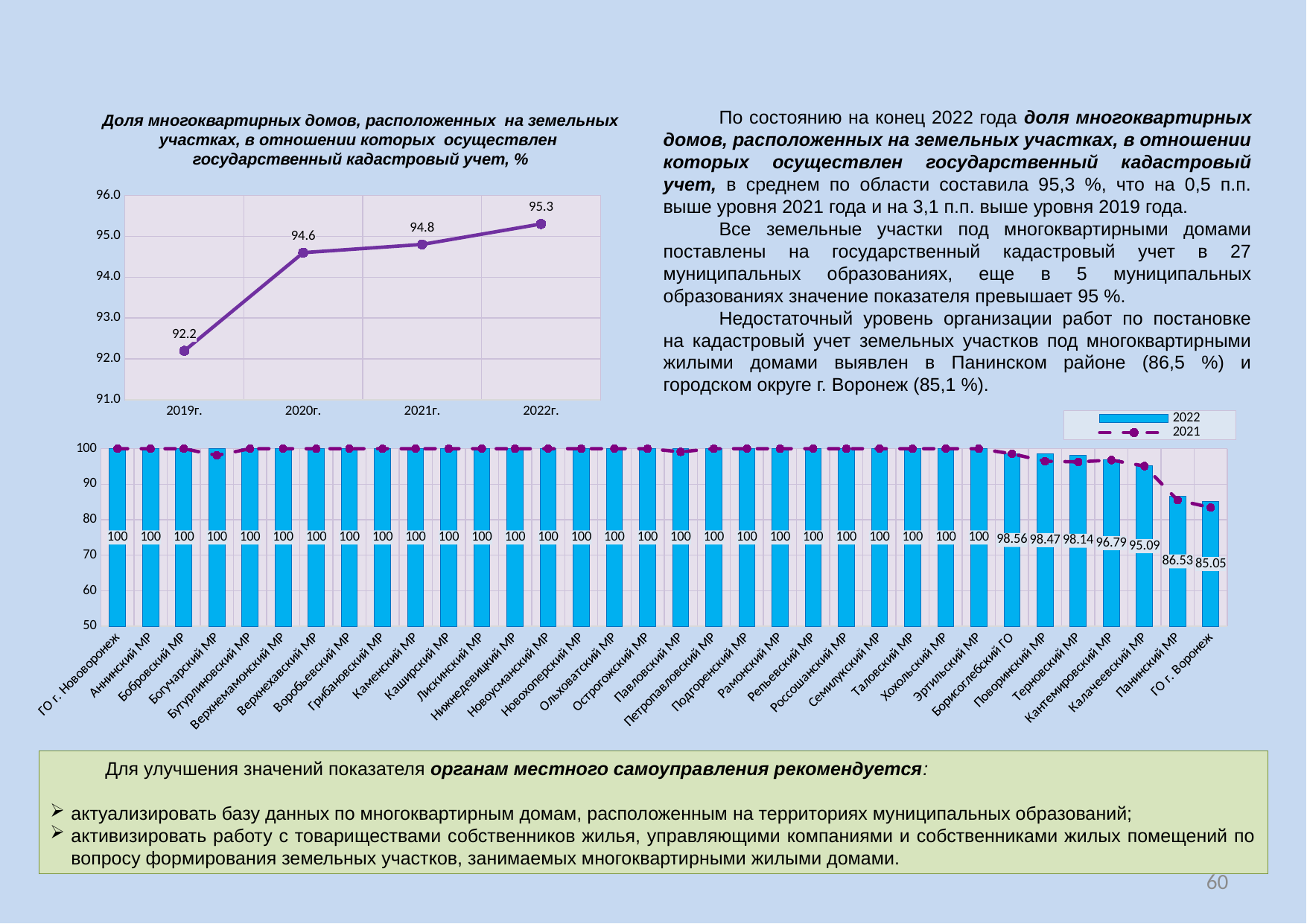
What kind of chart is the top-left chart? line chart In the bottom bar chart, which municipality has the lowest 2022 value? ГО г. Воронеж How many series does the legend of the bottom bar chart list? 2 In the top-left line chart, what is the value for 2019г.? 92.2 In the top-left line chart, what is the difference between the 2022г. and 2019г. values? 3.1 In the bottom bar chart, what is the difference between the 2022 values for Борисоглебский ГО and Поворинский МР? 0.09 In the top-left line chart, what is the value for 2022г.? 95.3 In the bottom bar chart, what is the 2022 value for ГО г. Воронеж? 85.05 In the top-left line chart, how many years are plotted? 4 In the top-left line chart, do the values rise or fall from 2019г. to 2022г.? rise In the bottom bar chart, which is larger, the 2022 value for Калачеевский МР or for Кантемировский МР? Кантемировский МР In the bottom bar chart, what is the 2022 value for Панинский МР? 86.53